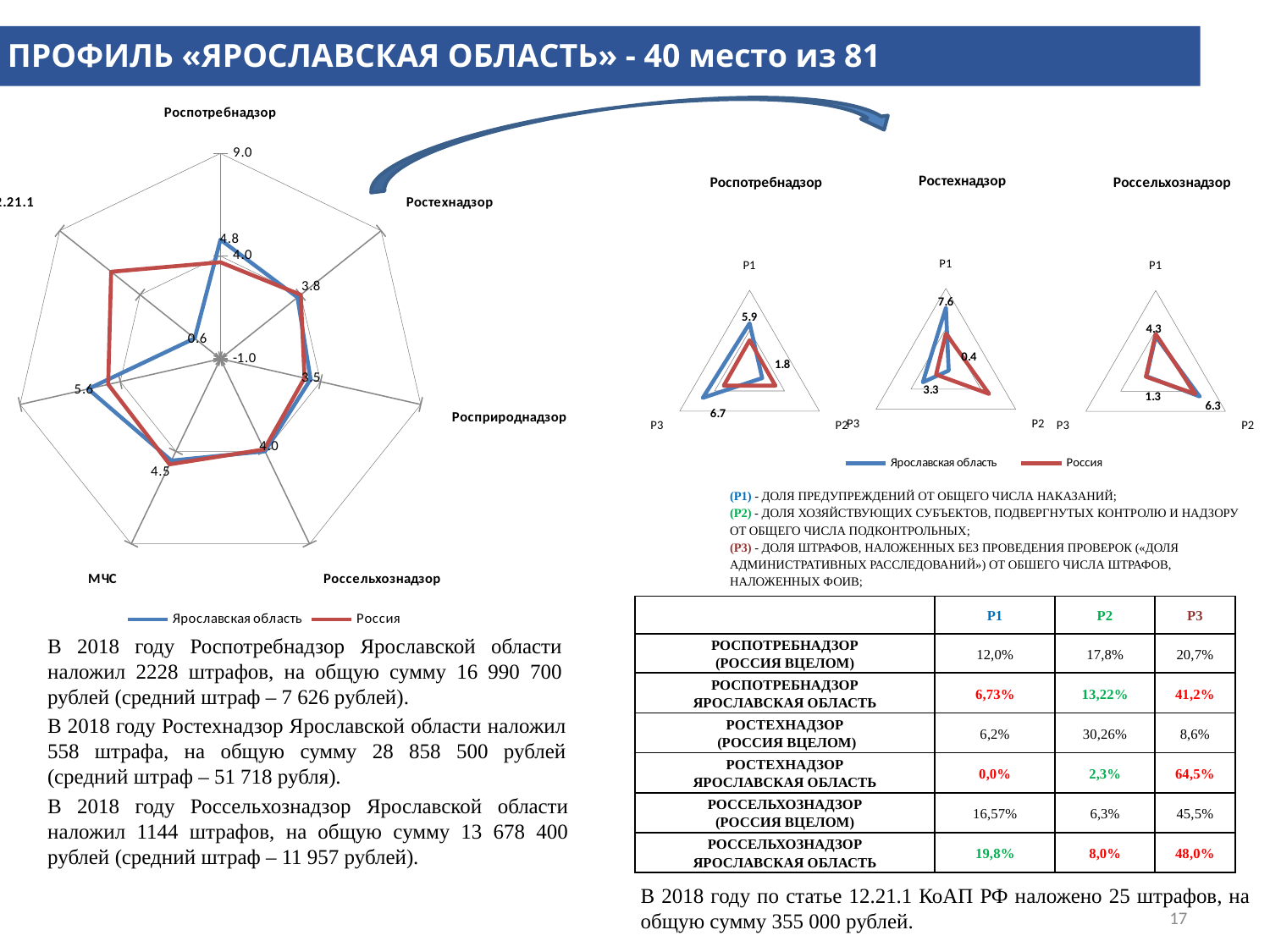
How many series does the legend of the large radar chart on the left list? 2 What kind of chart is the large chart on the left of the slide? Radar chart How many axes (categories) does the large radar chart on the left have? 7 How many axes does each small radar chart on the right have? 3 What are the two series named in the legend of the large radar chart on the left? Ярославская область and Россия In the small radar chart titled Роспотребнадзор, what is the largest labeled value? 6.7 In the small radar chart titled Россельхознадзор, which axis has the smallest labeled value? P3 In the small radar chart titled Ростехнадзор, what is the smallest labeled value? 0.4 How many small radar charts are shown on the right side of the slide? 3 In the small radar chart titled Ростехнадзор, which axis has the largest labeled value? P1 In the small radar chart titled Роспотребнадзор, which axis has the largest labeled value? P3 What is the highest axis tick value shown on the large radar chart on the left? 9.0